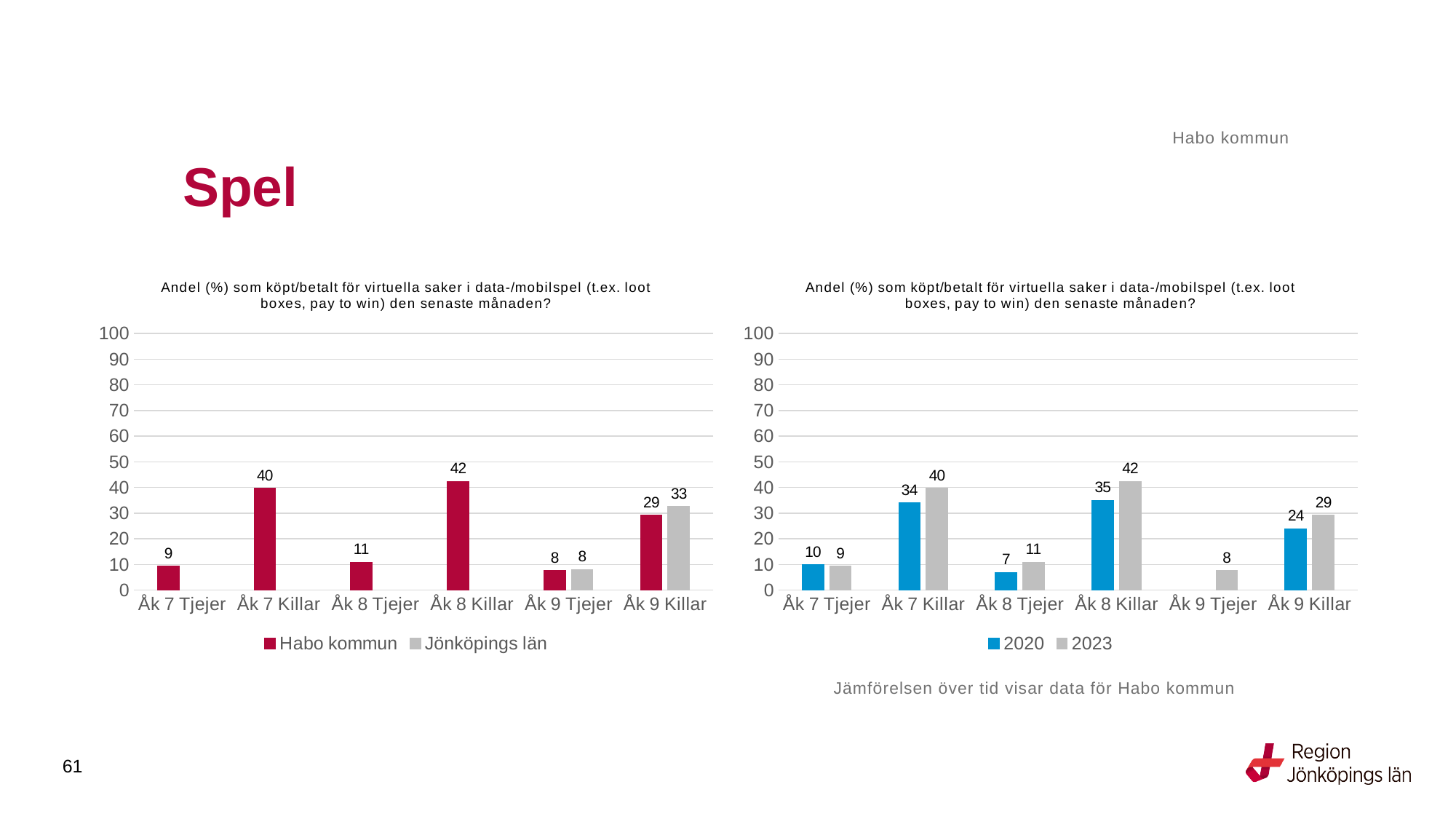
In the left chart, how many categories are shown on the x axis? 6 In the right chart, what is the difference between 2023 and 2020 for Åk 8 Killar? 7 In the right chart, what is the value for 2023 for Åk 9 Killar? 29 In the left chart, which category has the lowest value for Habo kommun? Åk 9 Tjejer In the left chart, which category has the highest value for Habo kommun? Åk 8 Killar In the right chart, which is larger for Åk 8 Tjejer, 2020 or 2023? 2023 In the right chart, what is the value for 2020 for Åk 7 Killar? 34 In the right chart, how many series does the legend list? 2 In the left chart, what is the value for Jönköpings län for Åk 9 Killar? 33 In the left chart, what is the value for Habo kommun for Åk 8 Killar? 42 In the left chart, what is the difference between Jönköpings län and Habo kommun for Åk 9 Killar? 4 What type of chart is the right chart? Bar chart